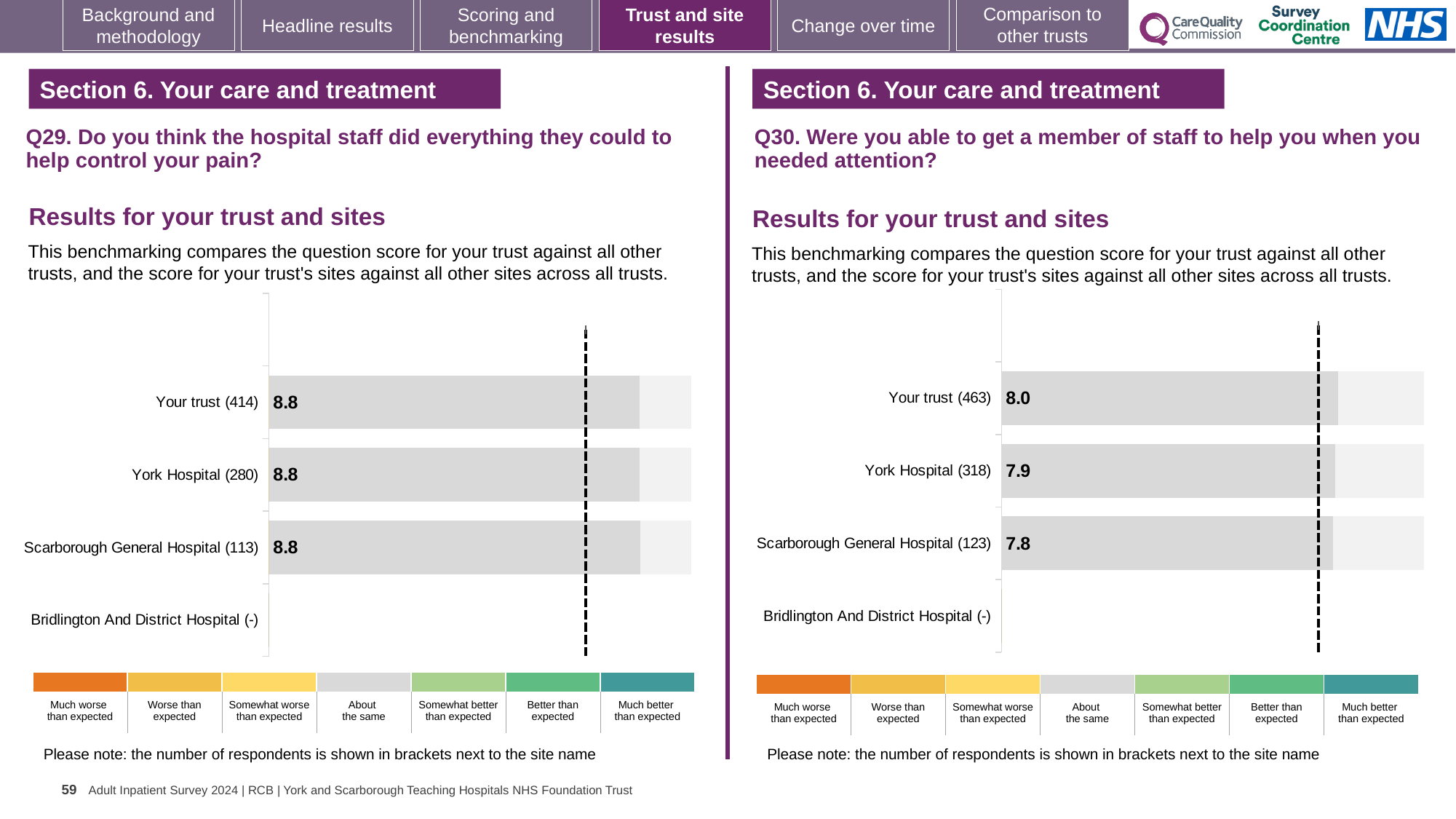
In the Q30 chart on the right, what is the score for Your trust (463)? 8.0 In the Q30 chart on the right, what is the difference between the scores for Your trust (463) and Scarborough General Hospital (123)? 0.2 In the Q29 chart on the left, which site has no score shown, indicated by (-)? Bridlington And District Hospital In the Q29 chart on the left, is the score for York Hospital (280) higher than, lower than, or equal to the score for Your trust (414)? equal In the Q30 chart on the right, what is the score for Scarborough General Hospital (123)? 7.8 In the Q30 chart on the right, which site or trust has the highest score? Your trust (463) In the Q30 chart on the right, which site with a printed score has the lowest score? Scarborough General Hospital (123) In the Q29 chart on the left, what is the score for Your trust (414)? 8.8 What type of chart is used in the Q30 chart on the right? bar chart In the Q30 chart on the right, what is the score for York Hospital (318)? 7.9 In the Q29 chart on the left, what is the score for Scarborough General Hospital (113)? 8.8 How many sites or trusts are listed on the y axis of the Q29 chart on the left? 4